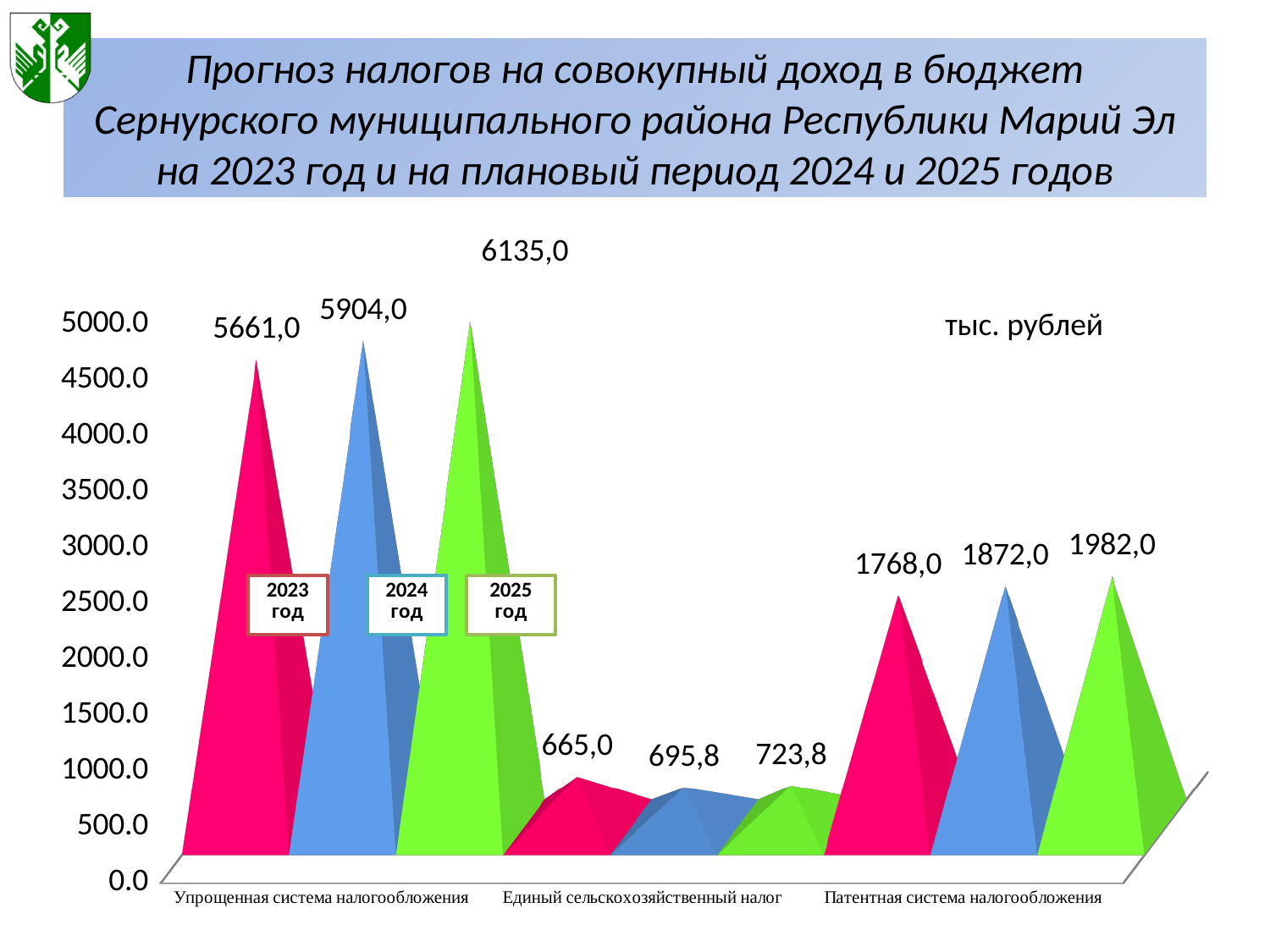
How many categories are shown on the x axis? 3 What unit is indicated on the chart? тыс. рублей What is the 2023 год value for Упрощенная система налогообложения? 5661,0 What is the difference between the 2025 год and 2023 год values for Упрощенная система налогообложения? 474,0 What is the difference between the 2025 год and 2023 год values for Патентная система налогообложения? 214,0 How many series does the legend list? 3 What is the 2025 год value for Единый сельскохозяйственный налог? 723,8 Which category has the highest values across all three years? Упрощенная система налогообложения Which is larger for Единый сельскохозяйственный налог: the 2024 год value or the 2025 год value? 2025 год What is the 2024 год value for Патентная система налогообложения? 1872,0 Do the values for Патентная система налогообложения rise or fall from 2023 год to 2025 год? rise Which category has the lowest values across all three years? Единый сельскохозяйственный налог